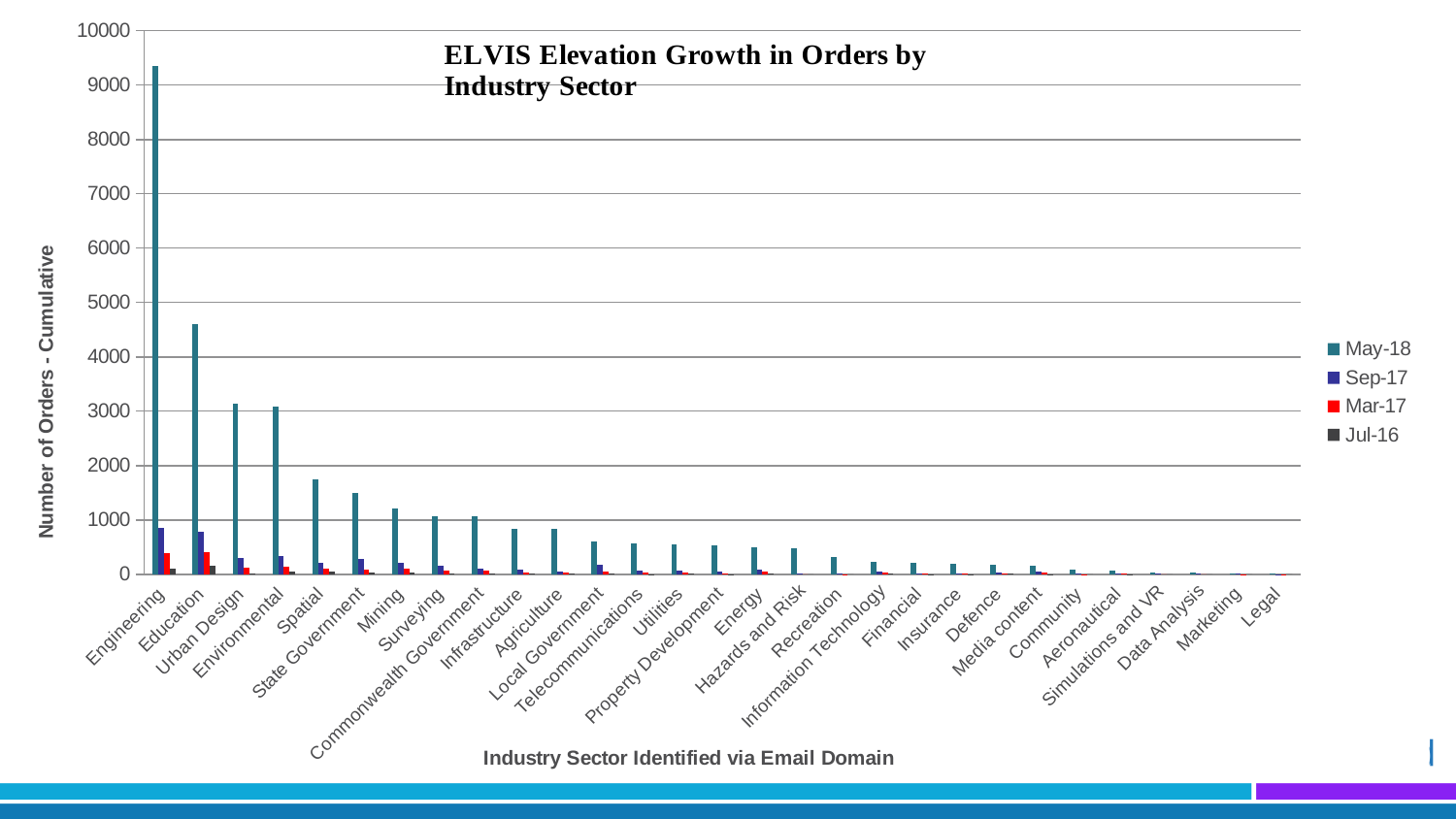
Is the May-18 value for Engineering greater or less than 9000? greater Is the May-18 value for Education greater or less than 5000? less Which has the larger May-18 value, Education or Urban Design? Education Is the May-18 value for Spatial greater or less than 2000? less Do the May-18 values rise or fall moving from left to right along the x axis? fall Which industry sector has the highest May-18 value? Engineering How many industry sectors are shown along the x axis? 29 What is the title of the chart? ELVIS Elevation Growth in Orders by Industry Sector What is the label of the y axis? Number of Orders - Cumulative What kind of chart is shown on the slide? bar chart How many series does the legend list? 4